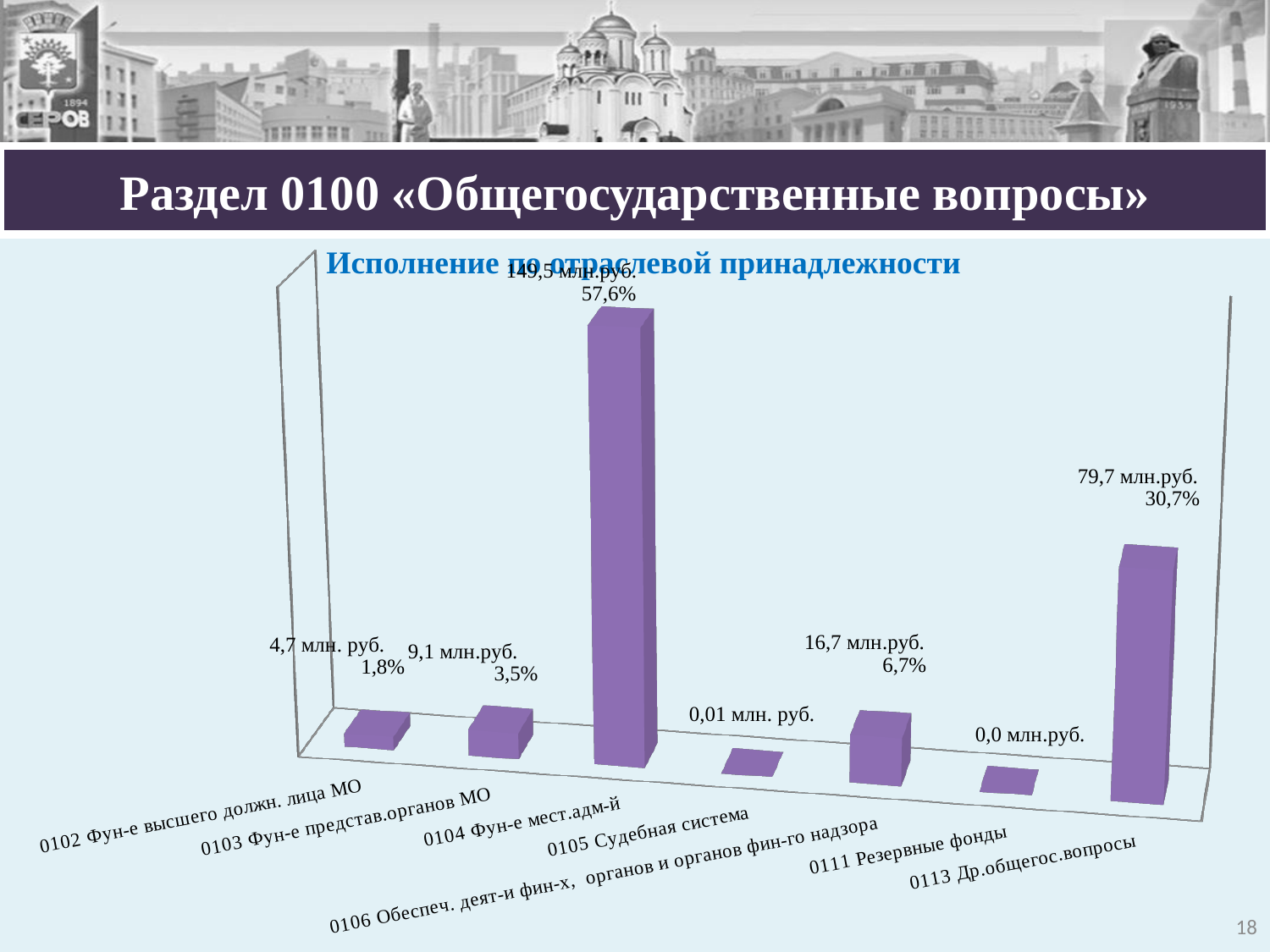
What is the title of the chart? Исполнение по отраслевой принадлежности What percentage is shown for category 0113 Др.общегос.вопросы? 30,7% Which category has the lowest value? 0111 Резервные фонды What is the value shown for category 0104 Фун-е мест.адм-й? 149,5 млн.руб. What is the value shown for category 0105 Судебная система? 0,01 млн. руб. Which category has the highest value? 0104 Фун-е мест.адм-й What percentage is shown for category 0102 Фун-е высшего должн. лица МО? 1,8% What is the value shown for category 0106 Обеспеч. деят-и фин-х, органов и органов фин-го надзора? 16,7 млн.руб. What is the difference in value between 0104 Фун-е мест.адм-й and 0113 Др.общегос.вопросы? 69,8 млн.руб. What kind of chart is shown on the slide? Bar chart How many categories are shown in the chart? 7 Which is larger, the value for 0103 Фун-е представ.органов МО or for 0106 Обеспеч. деят-и фин-х, органов и органов фин-го надзора? 0106 Обеспеч. деят-и фин-х, органов и органов фин-го надзора